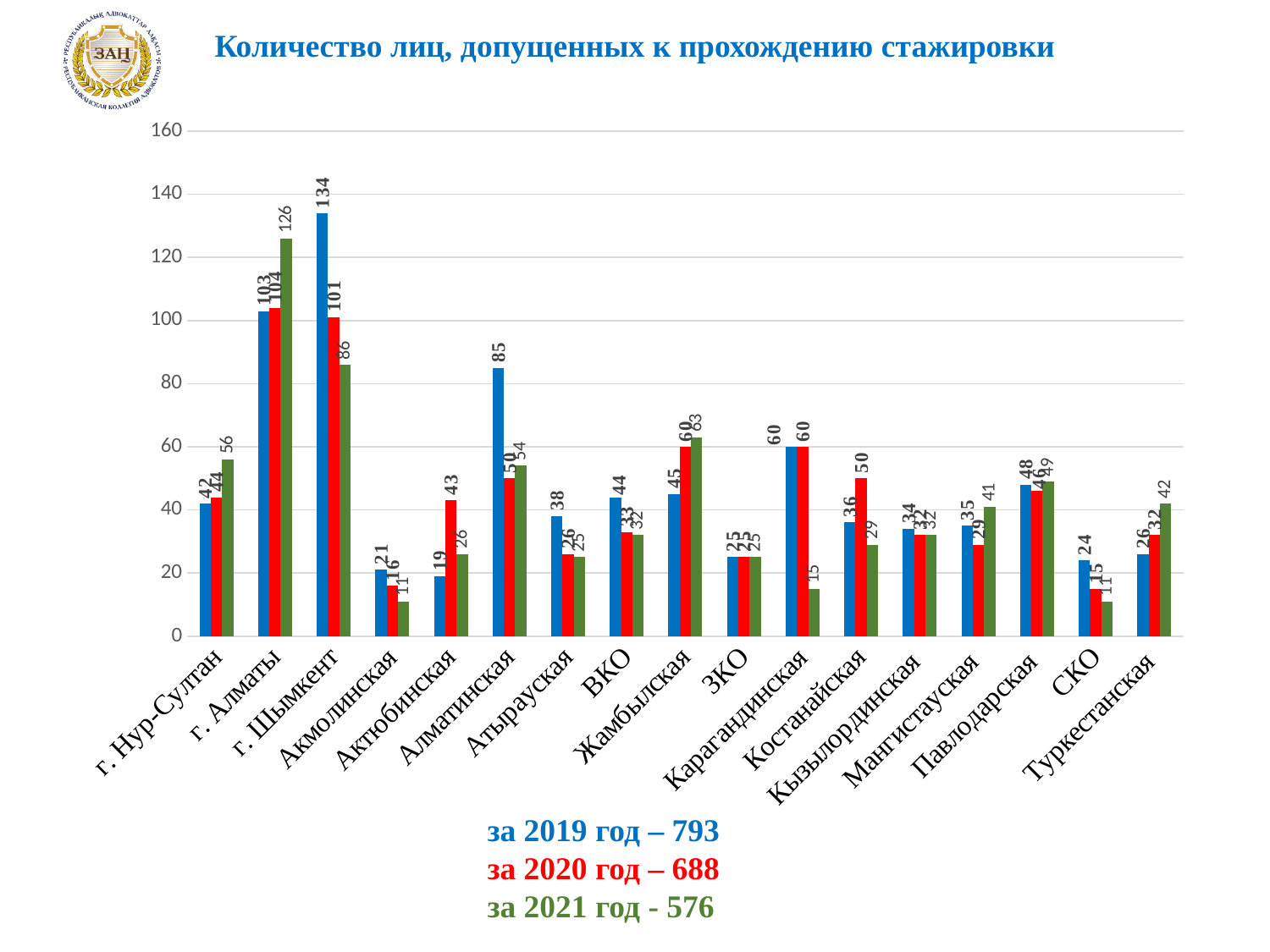
Which region has the highest 2019 value? г. Шымкент What type of chart is shown? bar chart Do the values for Акмолинская rise or fall from 2019 to 2021? fall What is the 2019 value for г. Шымкент? 134 What is the 2021 value for Карагандинская? 15 What is the 2021 value for г. Алматы? 126 What is the difference between the 2019 and 2021 values for г. Шымкент? 48 Which region has the lowest 2019 value? Актюбинская How many data series (years) are plotted in the chart? 3 What total is given on the slide for 2020? 688 How many regions are shown on the x axis? 17 For Актюбинская, which year has the larger value, 2019 or 2020? 2020